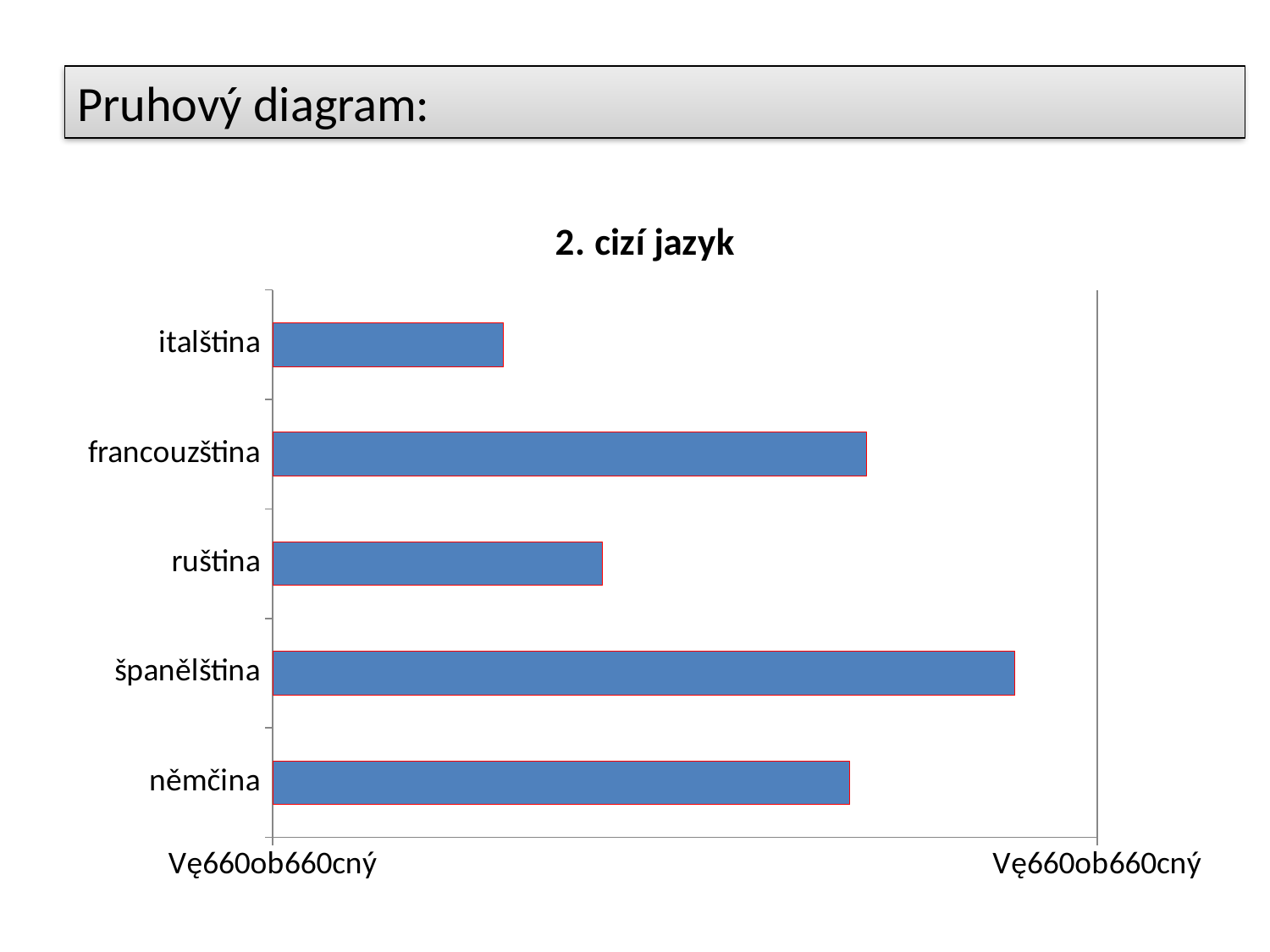
What is the title of the chart? 2. cizí jazyk Which language is listed at the top of the category axis? italština Which has the larger value, francouzština or ruština? francouzština Which language has the shortest bar in the chart? italština Which language has the longest bar in the chart? španělština What kind of chart is shown on the slide? bar chart Which has the larger value, španělština or němčina? španělština How many categories (languages) are plotted in the chart? 5 Which has the larger value, ruština or španělština? španělština